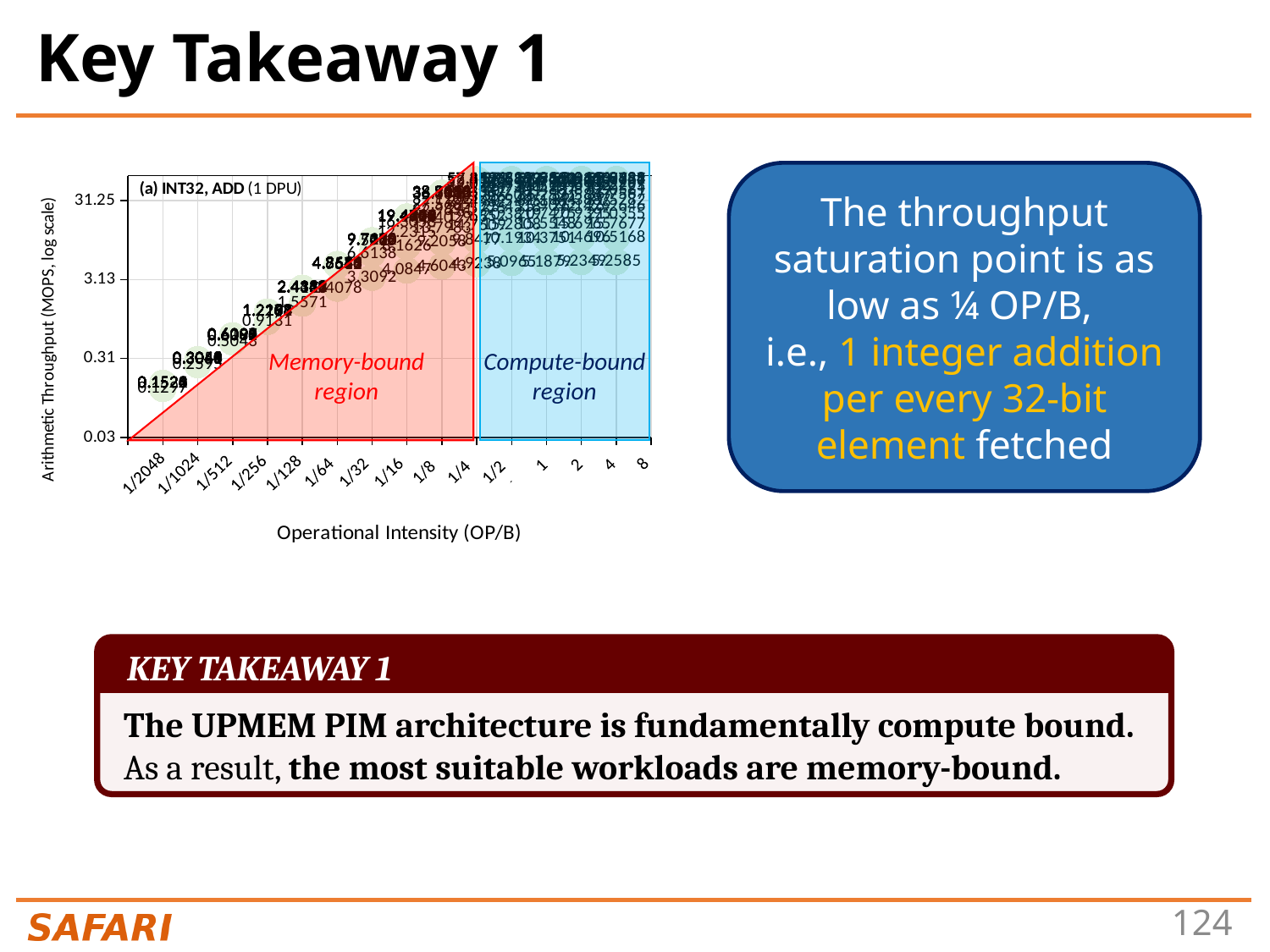
Is the arithmetic throughput at operational intensity 8 greater or less than 3.13? greater What is the highest tick value shown on the y axis of the chart? 31.25 What is the title of the x axis of the chart? Operational Intensity (OP/B) Is the arithmetic throughput at operational intensity 1/512 greater or less than 3.13? less Is the arithmetic throughput at operational intensity 1/64 greater or less than 0.31? greater Which operational intensity has the lowest arithmetic throughput in the chart? 1/2048 How many operational intensity tick labels are shown on the x axis of the chart? 15 Does the arithmetic throughput rise or fall as operational intensity increases from 1/2048 to 1/4? rise What is the title of the y axis of the chart? Arithmetic Throughput (MOPS, log scale) Which has the higher arithmetic throughput: operational intensity 1/2048 or 1/4? 1/4